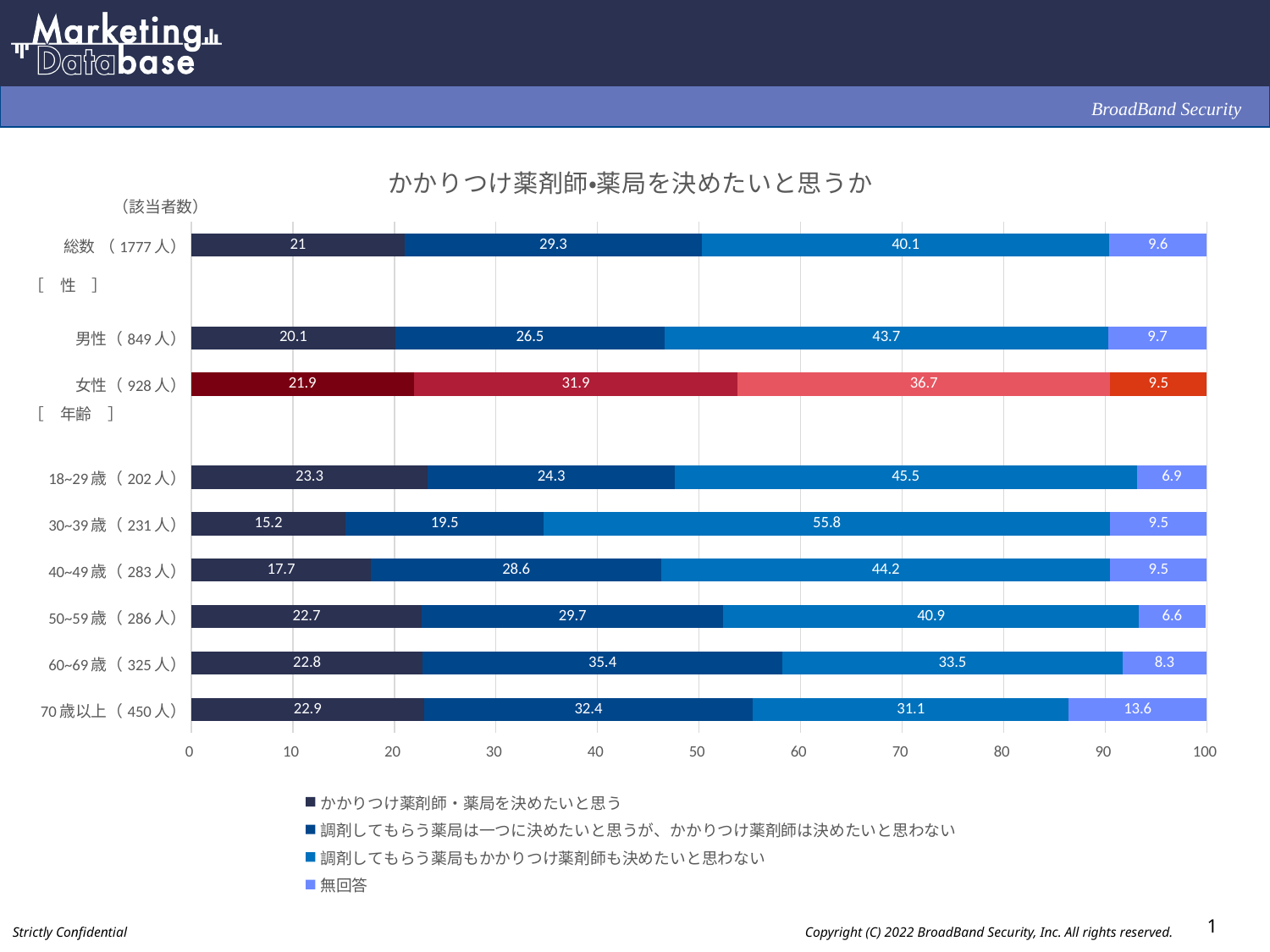
Which is larger for 「調剤してもらう薬局は一つに決めたいと思うが、かかりつけ薬剤師は決めたいと思わない」: 60~69歳 or 70歳以上? 60~69歳 Which category's bar is drawn in red shades instead of blue? 女性 (928人) What is the 無回答 value for 70歳以上 (450人)? 13.6 What type of chart is shown on the slide? Stacked bar chart Which age group has the highest value for 「調剤してもらう薬局もかかりつけ薬剤師も決めたいと思わない」? 30~39歳 (231人) What is the difference between 男性 and 女性 for 「調剤してもらう薬局もかかりつけ薬剤師も決めたいと思わない」? 7 How many categories (bars) are plotted in the chart? 9 How many series does the legend list? 4 Which category has the lowest value for 「かかりつけ薬剤師・薬局を決めたいと思う」? 30~39歳 (231人) What is the value of 「かかりつけ薬剤師・薬局を決めたいと思う」 for 総数 (1777人)? 21 What is the total of the stacked bar for 50~59歳 (286人)? 99.9 What is the value of 「調剤してもらう薬局もかかりつけ薬剤師も決めたいと思わない」 for 30~39歳 (231人)? 55.8